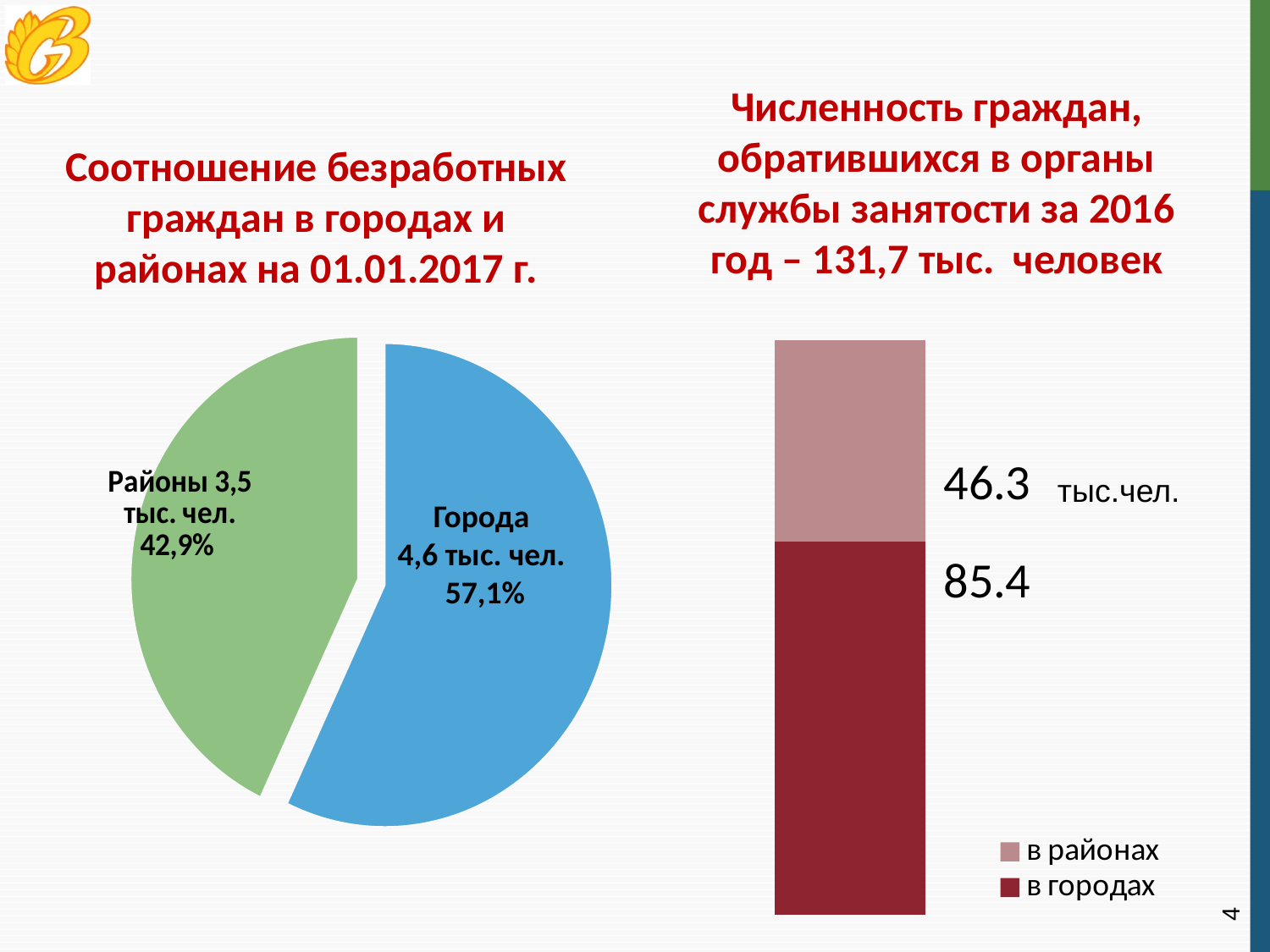
In the pie chart on the left, what share of unemployed citizens is in Районы? 42,9% How many slices does the pie chart on the left have? 2 How many series does the legend of the stacked bar chart on the right list? 2 In the pie chart on the left, which category has the larger slice, Города or Районы? Города In the stacked bar chart on the right, what is the value for в городах? 85.4 In the pie chart on the left, how many thousand unemployed citizens are in Районы? 3,5 тыс. чел. In the stacked bar chart on the right, what is the difference between the values for в городах and в районах? 39.1 What kind of chart is shown on the left side of the slide? pie chart In the pie chart on the left, what share of unemployed citizens is in Города? 57,1% In the stacked bar chart on the right, what is the value for в районах? 46.3 In the stacked bar chart on the right, which colour represents в районах? light pink What kind of chart is shown on the right side of the slide? stacked bar chart